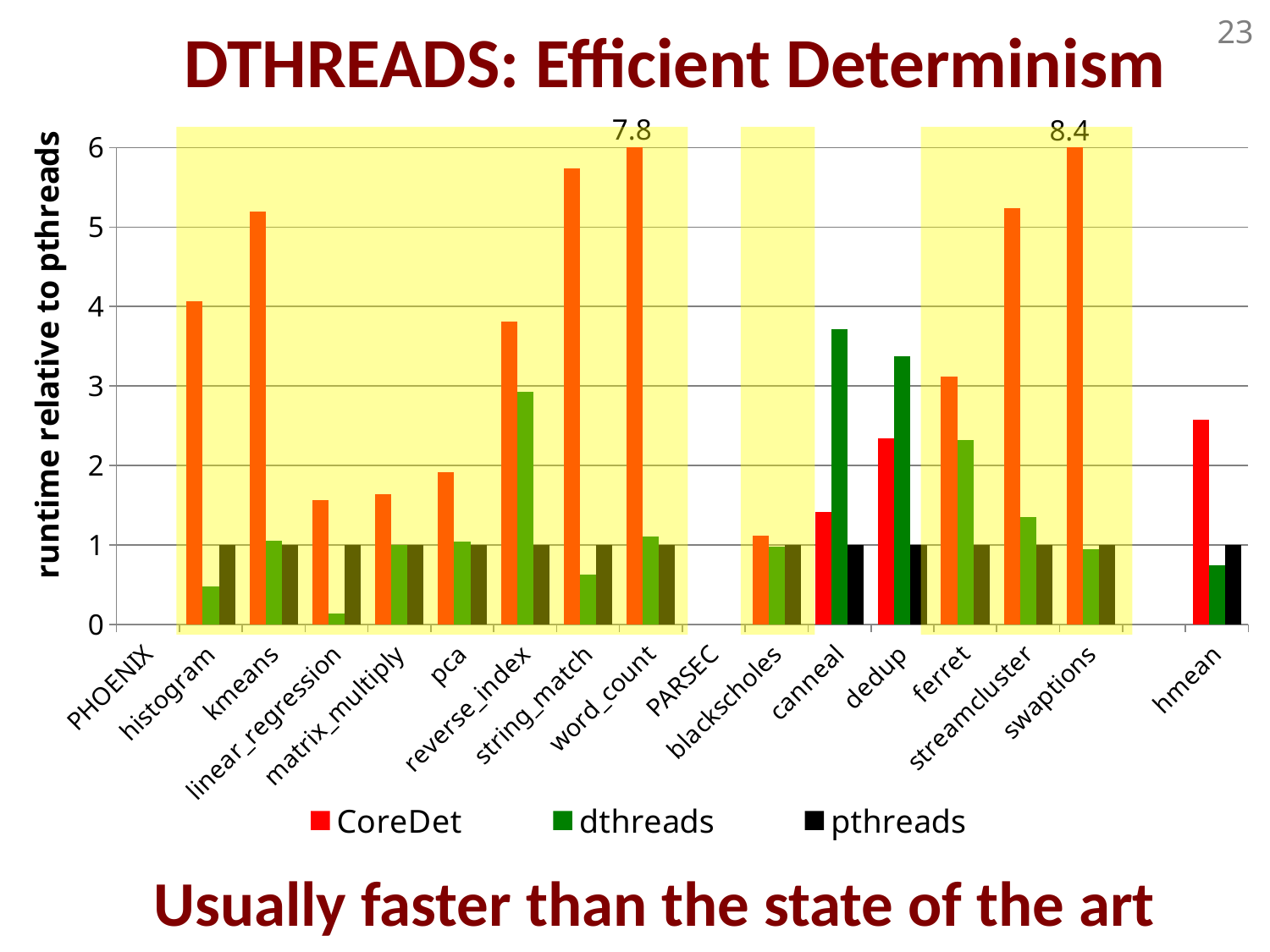
Is the dthreads value for canneal greater or less than 3? greater Is the CoreDet value for string_match greater or less than 5? greater What is the CoreDet value for word_count? 7.8 How many series does the legend list? 3 What kind of chart is shown on the slide? bar chart Which benchmark has the lowest dthreads runtime relative to pthreads? linear_regression What is the CoreDet value for swaptions? 8.4 For kmeans, which is larger: the CoreDet value or the dthreads value? CoreDet Which benchmark has the highest CoreDet runtime relative to pthreads? swaptions For canneal, which is larger: the CoreDet value or the dthreads value? dthreads What is the difference between the CoreDet values for swaptions and word_count? 0.6 Is the dthreads value for linear_regression greater or less than 0.5? less